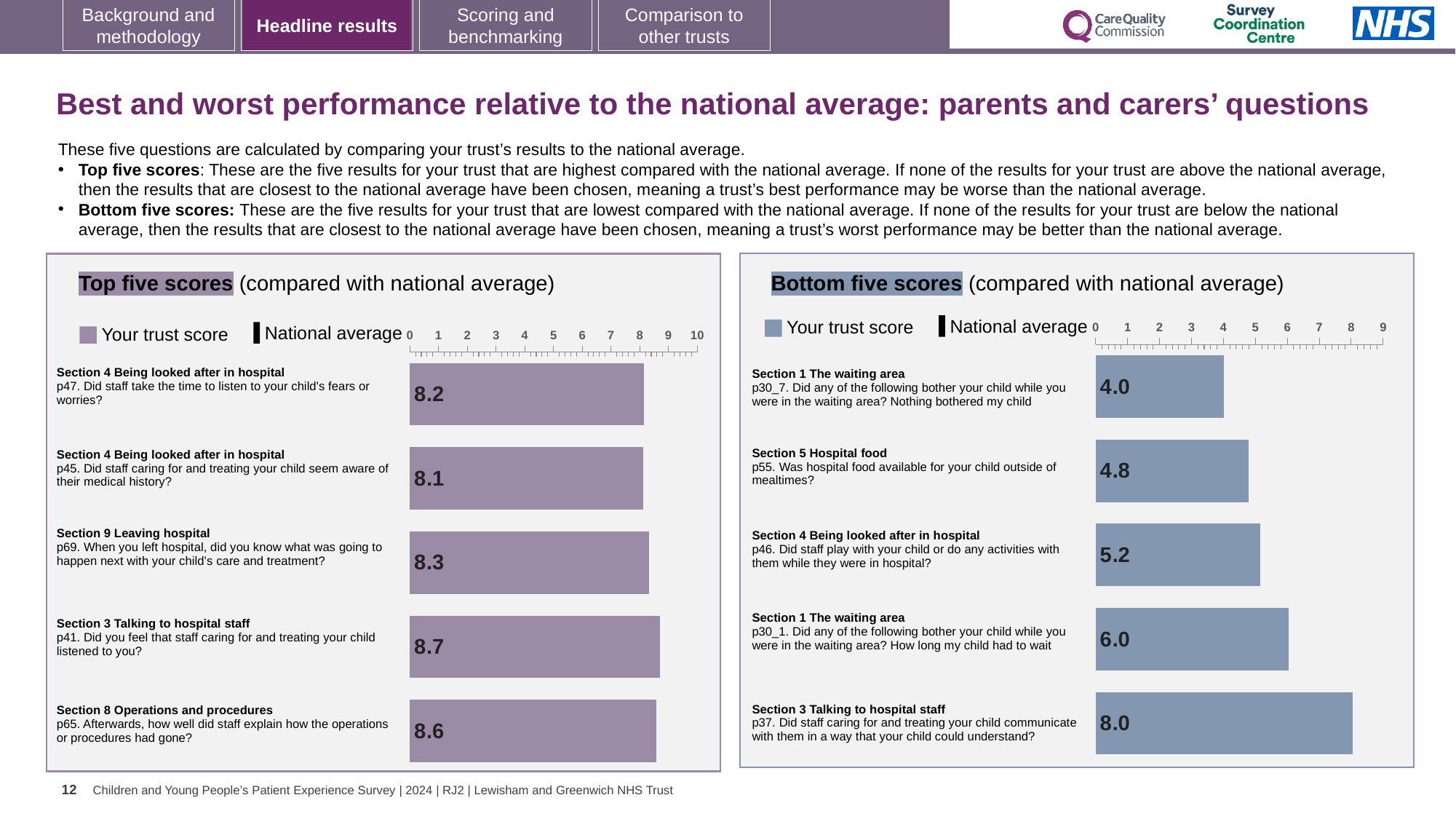
In the Top five scores chart, which question has the highest trust score? p41. Did you feel that staff caring for and treating your child listened to you? In the Top five scores chart, what is the trust score for p41 (Did you feel that staff caring for and treating your child listened to you?)? 8.7 In the Top five scores chart, which question has the lowest trust score? p45. Did staff caring for and treating your child seem aware of their medical history? In the Bottom five scores chart, which question has the highest trust score? p37. Did staff caring for and treating your child communicate with them in a way that your child could understand? What type of chart is the Top five scores chart? bar chart In the Bottom five scores chart, is the trust score for p46 larger or smaller than the trust score for p30_1? smaller In the Top five scores chart, what is the trust score for p69 (When you left hospital, did you know what was going to happen next with your child's care and treatment?)? 8.3 In the Bottom five scores chart, what is the trust score for p55 (Was hospital food available for your child outside of mealtimes?)? 4.8 In the Bottom five scores chart, what is the difference between the trust scores for p37 and p30_7? 4.0 In the Bottom five scores chart, which question has the lowest trust score? p30_7. Did any of the following bother your child while you were in the waiting area? Nothing bothered my child In the Top five scores chart, what is the difference between the trust scores for p41 and p47? 0.5 How many questions are shown in the Bottom five scores chart? 5